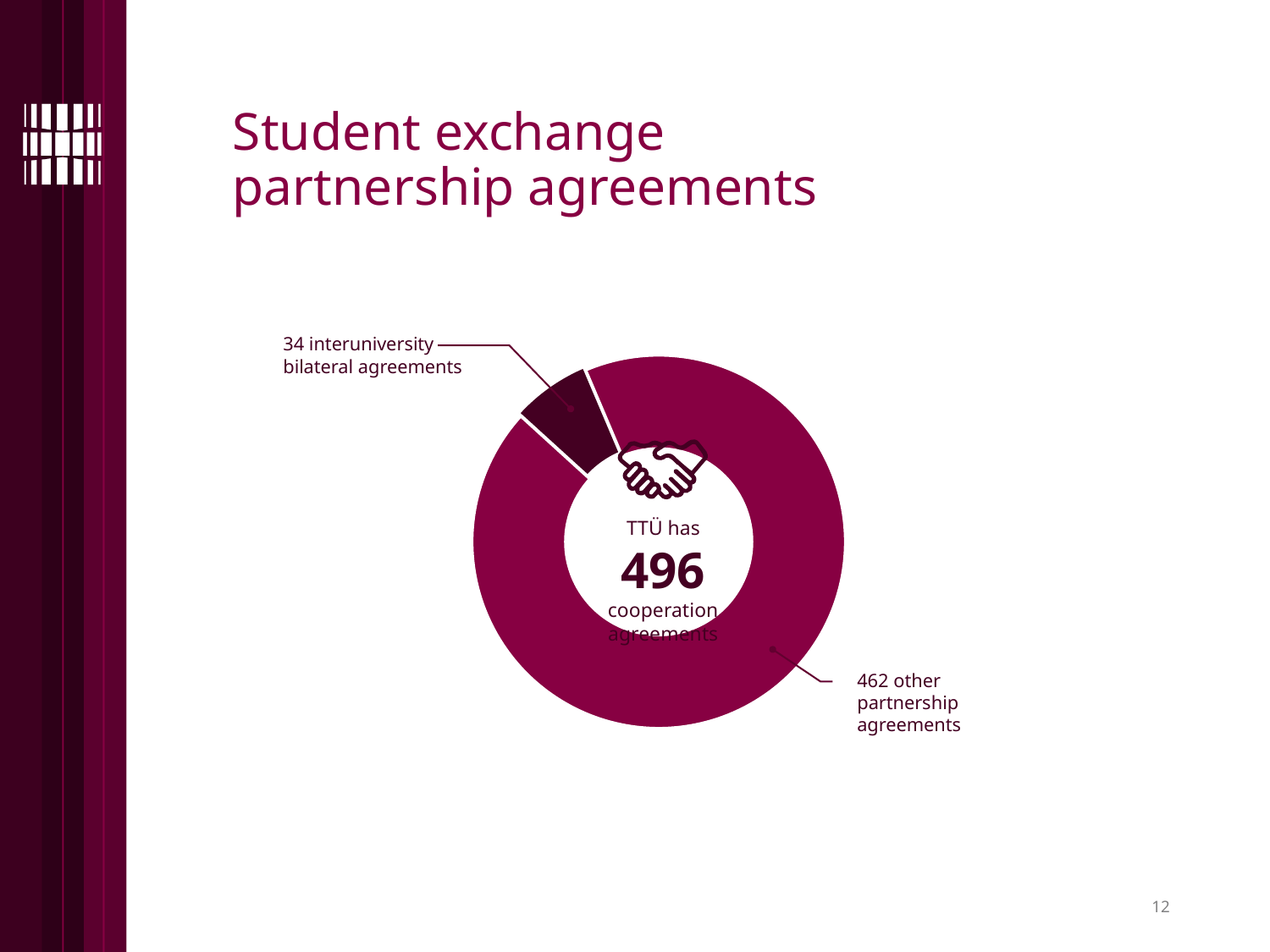
Which institution is named in the centre of the chart as having 496 cooperation agreements? TTÜ Which category has the larger slice: interuniversity bilateral agreements or other partnership agreements? Other partnership agreements What is the title of the slide containing the chart? Student exchange partnership agreements What is the total number of cooperation agreements shown in the centre of the chart? 496 How many other partnership agreements does the chart show? 462 How many categories (slices) does the chart have? 2 What is the difference between the number of other partnership agreements and the number of interuniversity bilateral agreements? 428 Which category has the smallest slice in the chart? Interuniversity bilateral agreements What kind of chart is shown on the slide? Donut (pie) chart Which category has the largest slice in the chart? Other partnership agreements How many interuniversity bilateral agreements does the chart show? 34